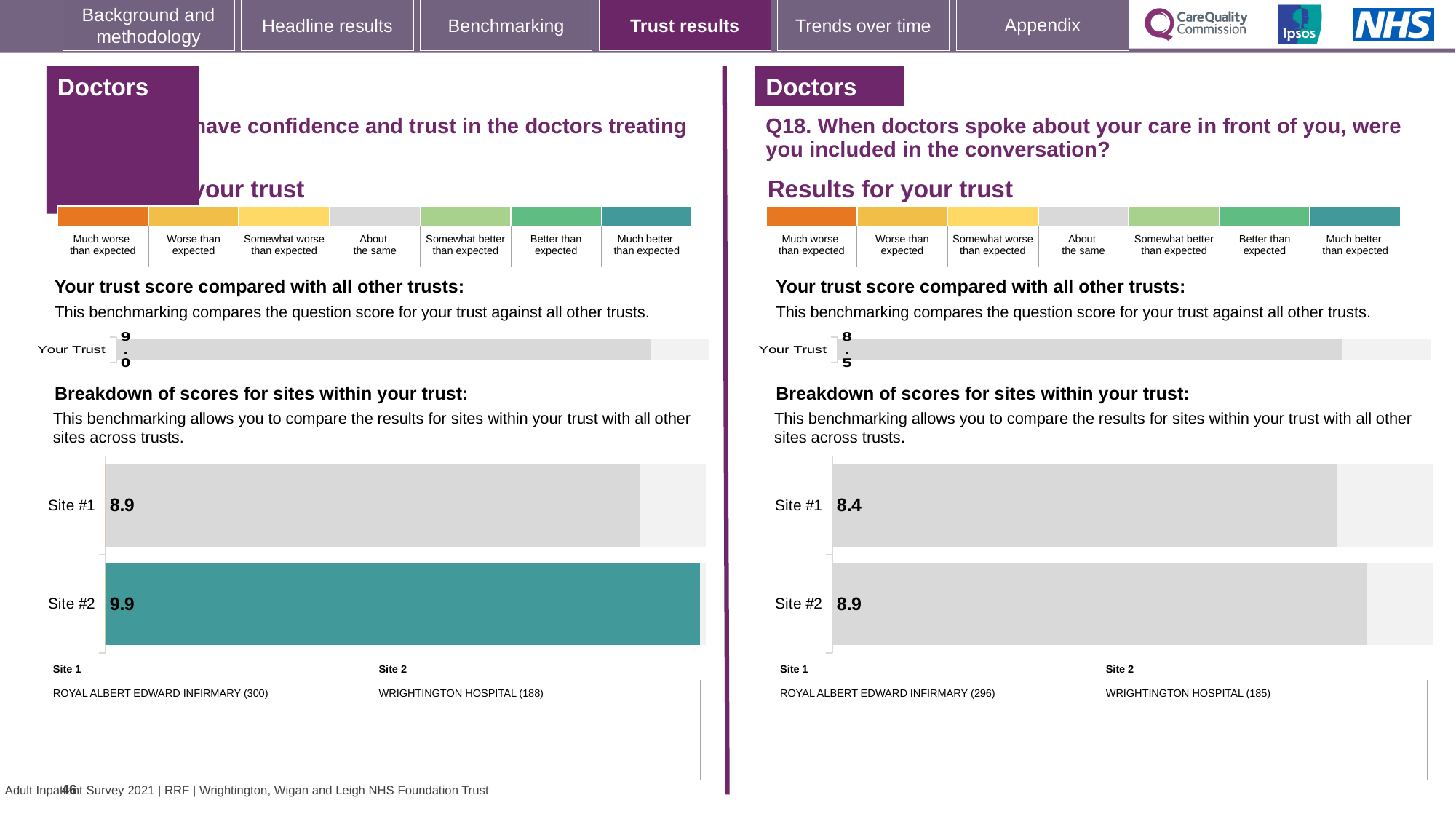
In the left-hand 'Breakdown of scores for sites within your trust' chart, what is the score for Site #2? 9.9 In the left-hand site breakdown chart, what is the difference between the Site #2 and Site #1 scores? 1.0 In the left-hand site breakdown chart, which site has the higher score? Site #2 How many sites are shown in the Q18 site breakdown chart on the right? 2 In the Q18 'Breakdown of scores for sites within your trust' chart on the right, what is the score for Site #1? 8.4 In the Q18 site breakdown chart on the right, which site has the lower score? Site #1 In the Q18 'Your trust score compared with all other trusts' chart on the right, what is the value for Your Trust? 8.5 What type of chart is used for the site breakdown on the left-hand side of the slide? Bar chart In the Q18 site breakdown chart on the right, what is the difference between the Site #2 and Site #1 scores? 0.5 In the left-hand 'Your trust score compared with all other trusts' chart, what is the value for Your Trust? 9.0 In the left-hand 'Breakdown of scores for sites within your trust' chart, what is the score for Site #1? 8.9 In the Q18 'Breakdown of scores for sites within your trust' chart on the right, what is the score for Site #2? 8.9